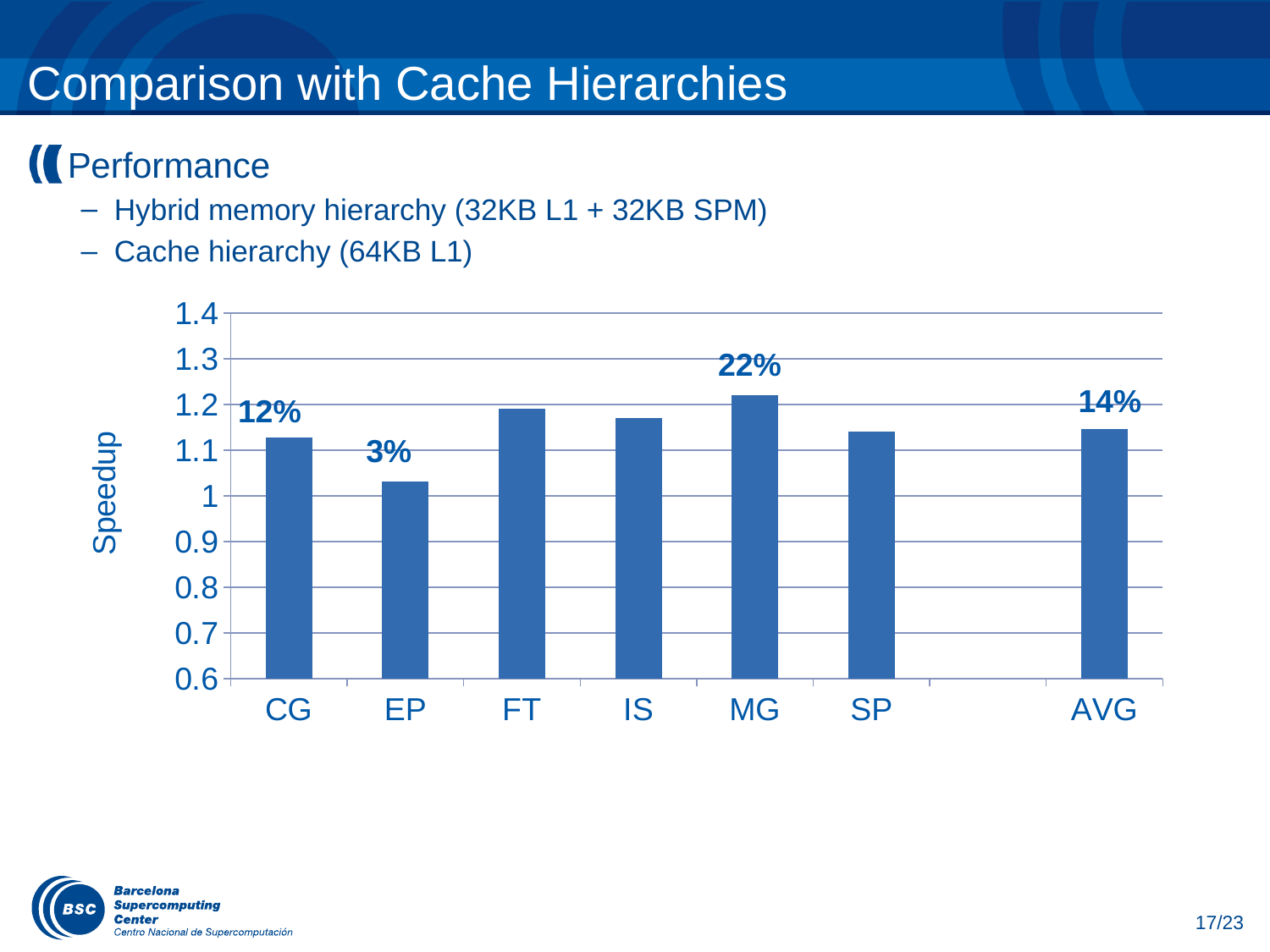
How many categories are shown on the x axis of the chart? 7 Which category has the lowest speedup? EP What percentage label is printed above the MG bar? 22% What kind of chart is shown on the slide? bar chart What percentage label is printed above the AVG bar? 14% What percentage label is printed above the CG bar? 12% Which has the larger speedup, FT or SP? FT What percentage label is printed above the EP bar? 3% Which category has the highest speedup? MG Is the speedup for FT greater or less than 1.1? greater What is the label on the y axis of the chart? Speedup Is the speedup for SP greater or less than 1.2? less